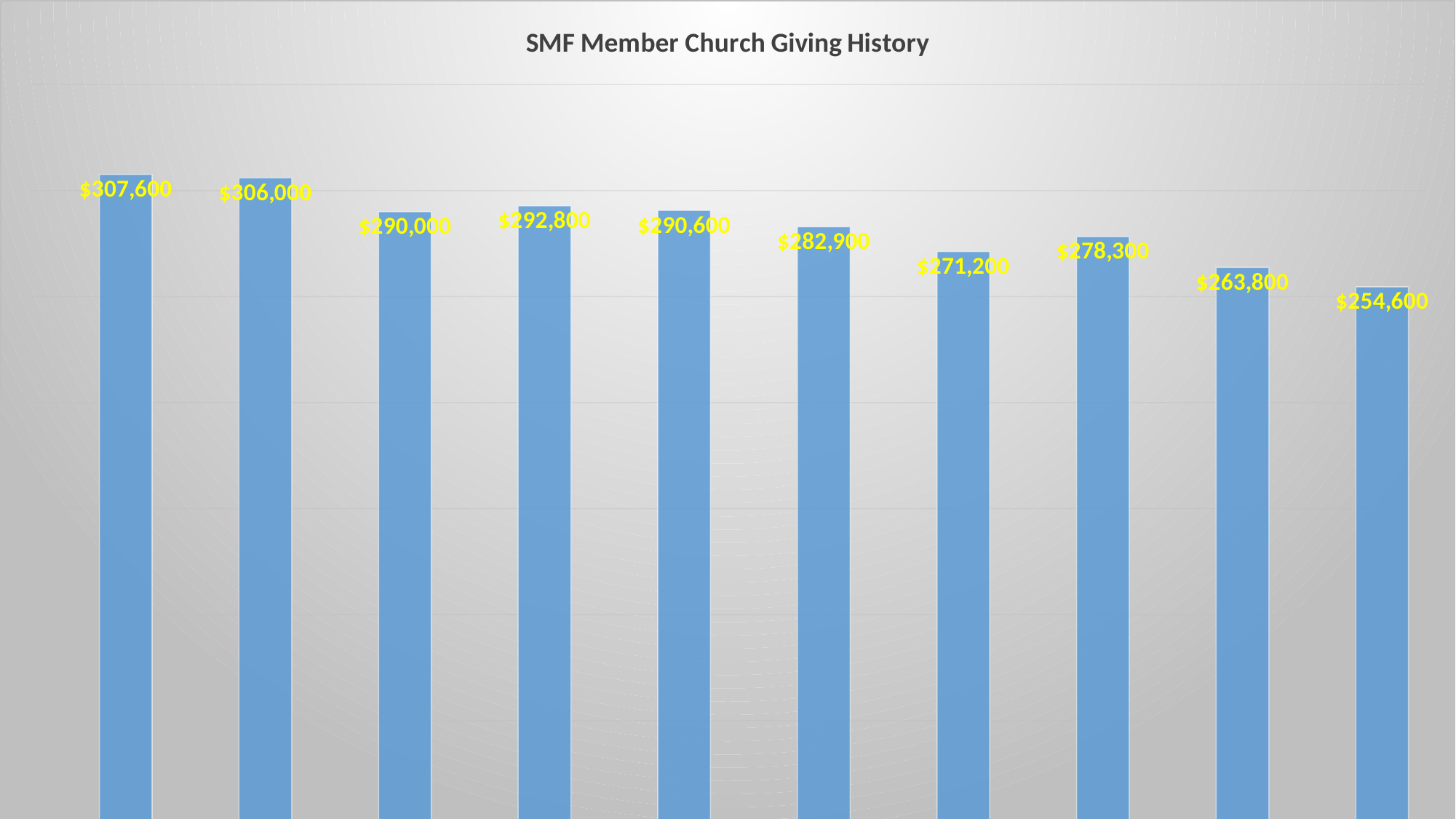
Which bar has the highest value? the leftmost (first) bar, $307,600 What is the difference between the leftmost bar and the rightmost bar? $53,000 What is the title of the chart? SMF Member Church Giving History What is the value shown on the seventh bar from the left? $271,200 What is the value shown on the rightmost bar? $254,600 What is the value shown on the fourth bar from the left? $292,800 Do the values generally rise or fall from left to right across the chart? fall Which bar has the lowest value? the rightmost (last) bar, $254,600 What is the value shown on the leftmost bar? $307,600 How many bars are plotted in the chart? 10 What kind of chart is shown on the slide? bar chart Which is larger, the seventh bar ($271,200) or the eighth bar ($278,300)? the eighth bar, $278,300